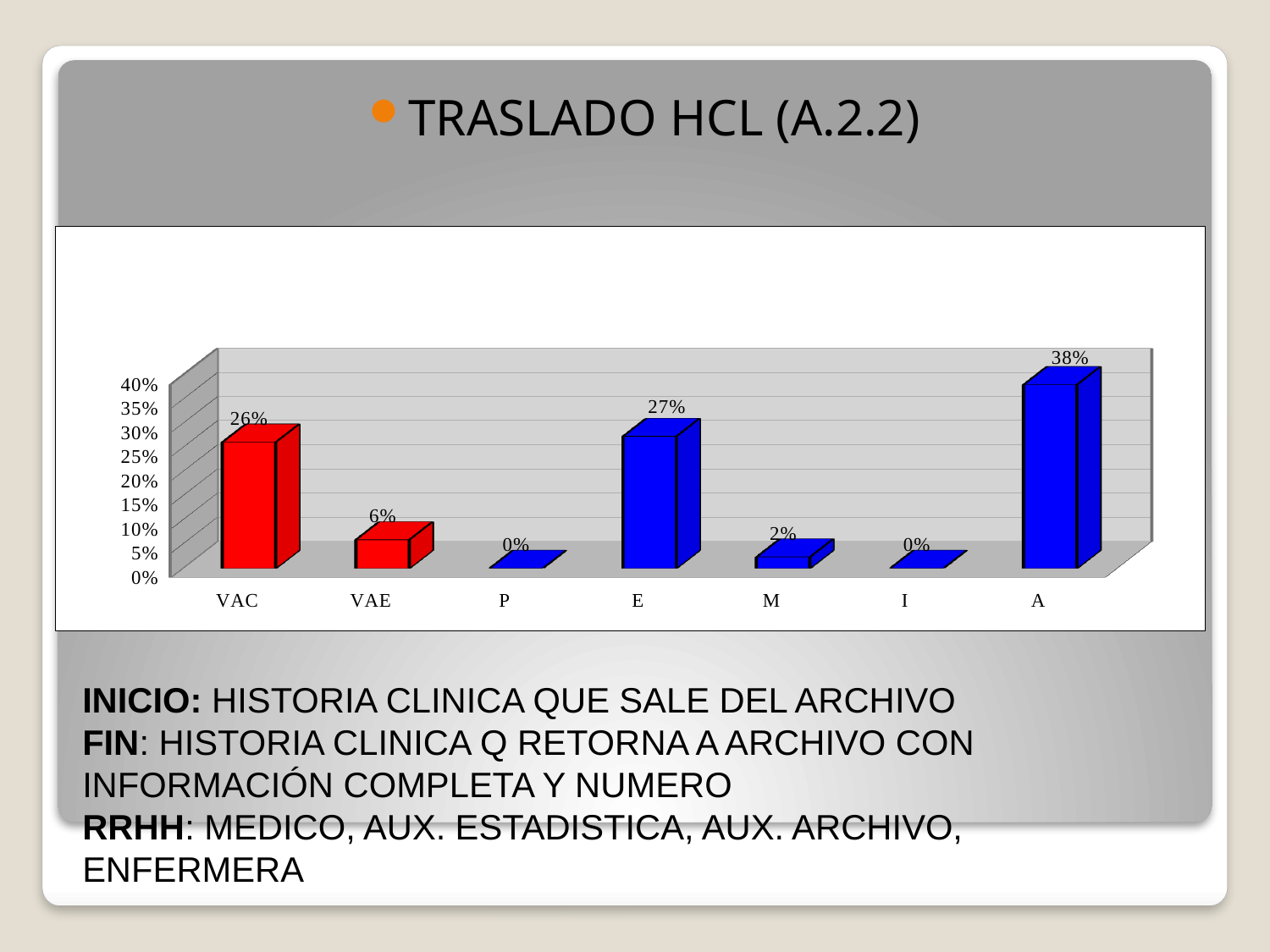
What is the value for VAE? 6% How many categories are shown on the x axis? 7 What colour are the bars for VAC and VAE? red What is the value for A? 38% Which categories have a value of 0%? P and I What is the value for E? 27% What is the value for VAC? 26% What is the difference between the values for A and VAC? 12% What kind of chart is shown on the slide? bar chart What is the value for M? 2% Which category has the highest value? A Which is larger, the value for VAC or the value for VAE? VAC